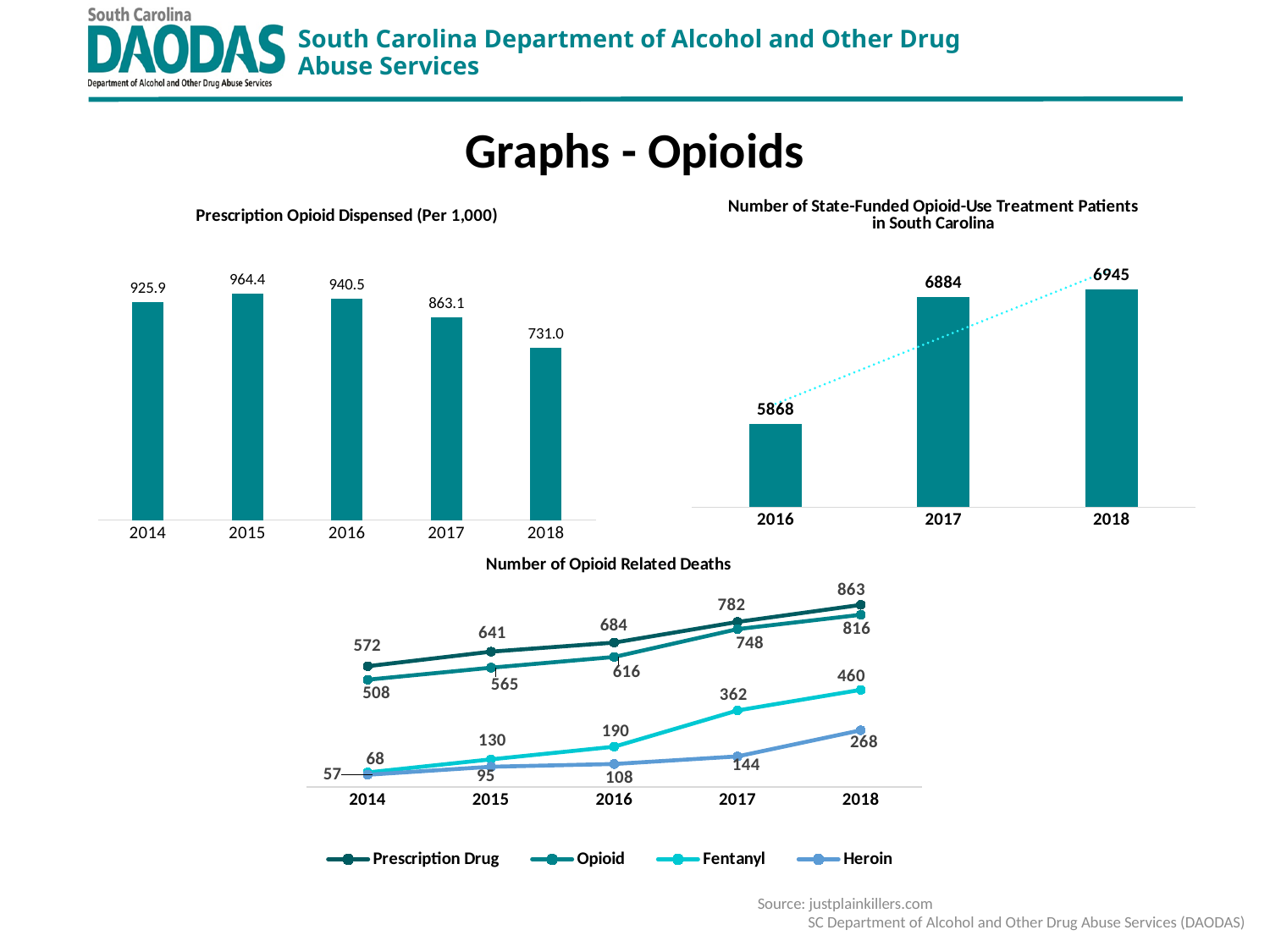
In the 'Number of State-Funded Opioid-Use Treatment Patients in South Carolina' chart, what is the value for 2017? 6884 How many series does the legend of the 'Number of Opioid Related Deaths' chart list? 4 In the 'Number of State-Funded Opioid-Use Treatment Patients in South Carolina' chart, do the values rise or fall from 2016 to 2018? rise What kind of chart is 'Number of Opioid Related Deaths'? line chart In the 'Prescription Opioid Dispensed (Per 1,000)' chart, which year has the lowest value? 2018 In the 'Number of State-Funded Opioid-Use Treatment Patients in South Carolina' chart, what is the difference between 2016 and 2018? 1077 In the 'Number of Opioid Related Deaths' chart, what is the Fentanyl value for 2017? 362 In the 'Prescription Opioid Dispensed (Per 1,000)' chart, what is the value for 2015? 964.4 In the 'Prescription Opioid Dispensed (Per 1,000)' chart, how many years are shown? 5 In the 'Prescription Opioid Dispensed (Per 1,000)' chart, what is the difference between the 2014 and 2018 values? 194.9 In the 'Number of Opioid Related Deaths' chart, which is larger in 2016: Fentanyl or Heroin? Fentanyl In the 'Number of Opioid Related Deaths' chart, which series has the highest value in 2018? Prescription Drug